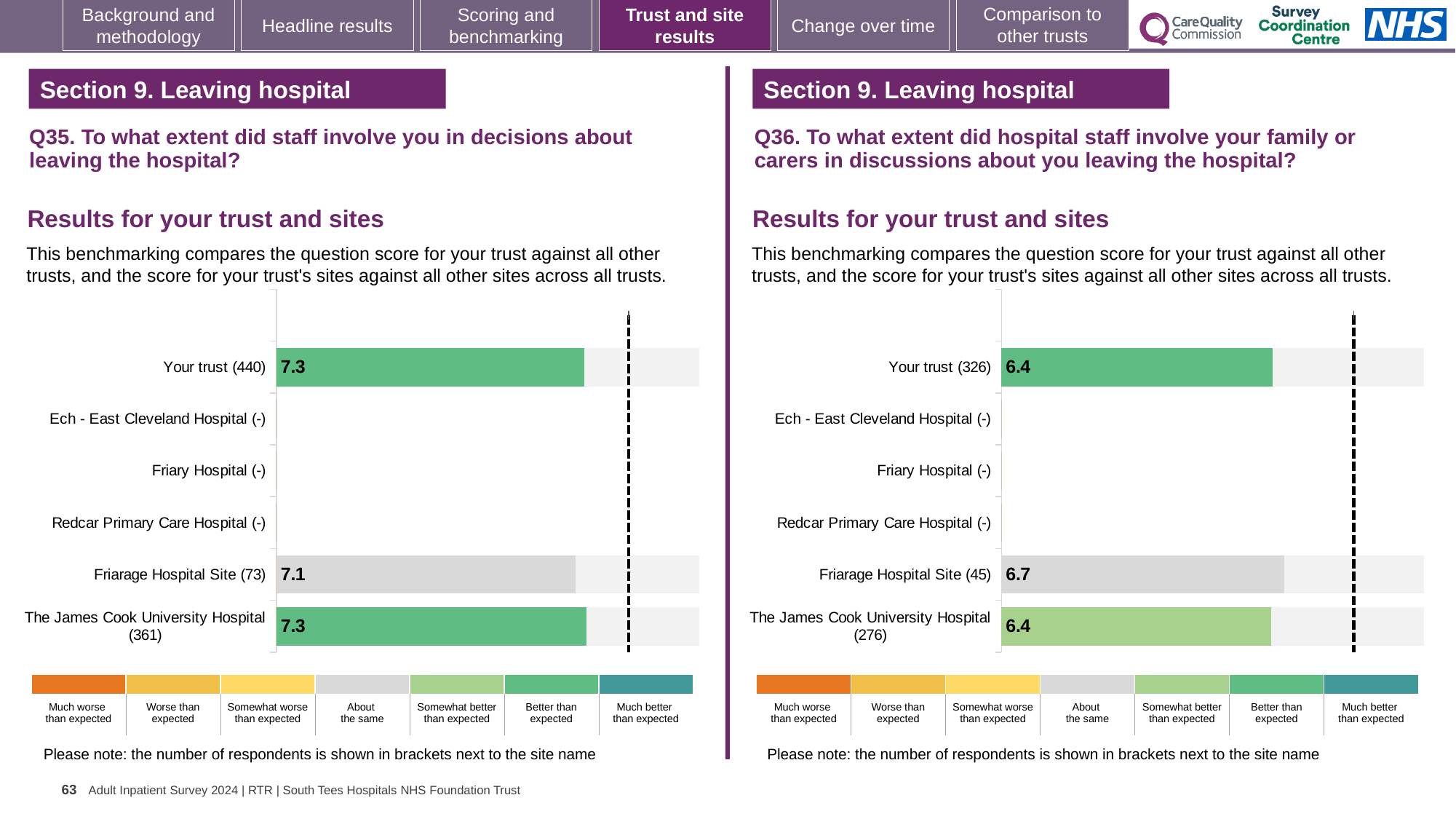
On the Q36 chart (right), what is the score for Friarage Hospital Site? 6.7 On the Q36 chart (right), what is the score for The James Cook University Hospital? 6.4 On the Q36 chart (right), how many respondents are shown in brackets for Your trust? 326 How many categories (rows) are listed on the Q35 chart (left)? 6 On the Q35 chart (left), what is the difference between the score for Your trust and the score for Friarage Hospital Site? 0.2 On the Q35 chart (left), what is the score for Friarage Hospital Site? 7.1 What kind of chart is used on the Q36 chart (right)? Bar chart On the Q35 chart (left), what is the score for Your trust? 7.3 On the Q36 chart (right), which is larger: the score for Friarage Hospital Site or the score for The James Cook University Hospital? Friarage Hospital Site On the Q36 chart (right), what is the difference between the score for Friarage Hospital Site and the score for Your trust? 0.3 On the Q36 chart (right), which site has the highest score? Friarage Hospital Site On the Q35 chart (left), which site has the lowest score among those with a plotted bar? Friarage Hospital Site